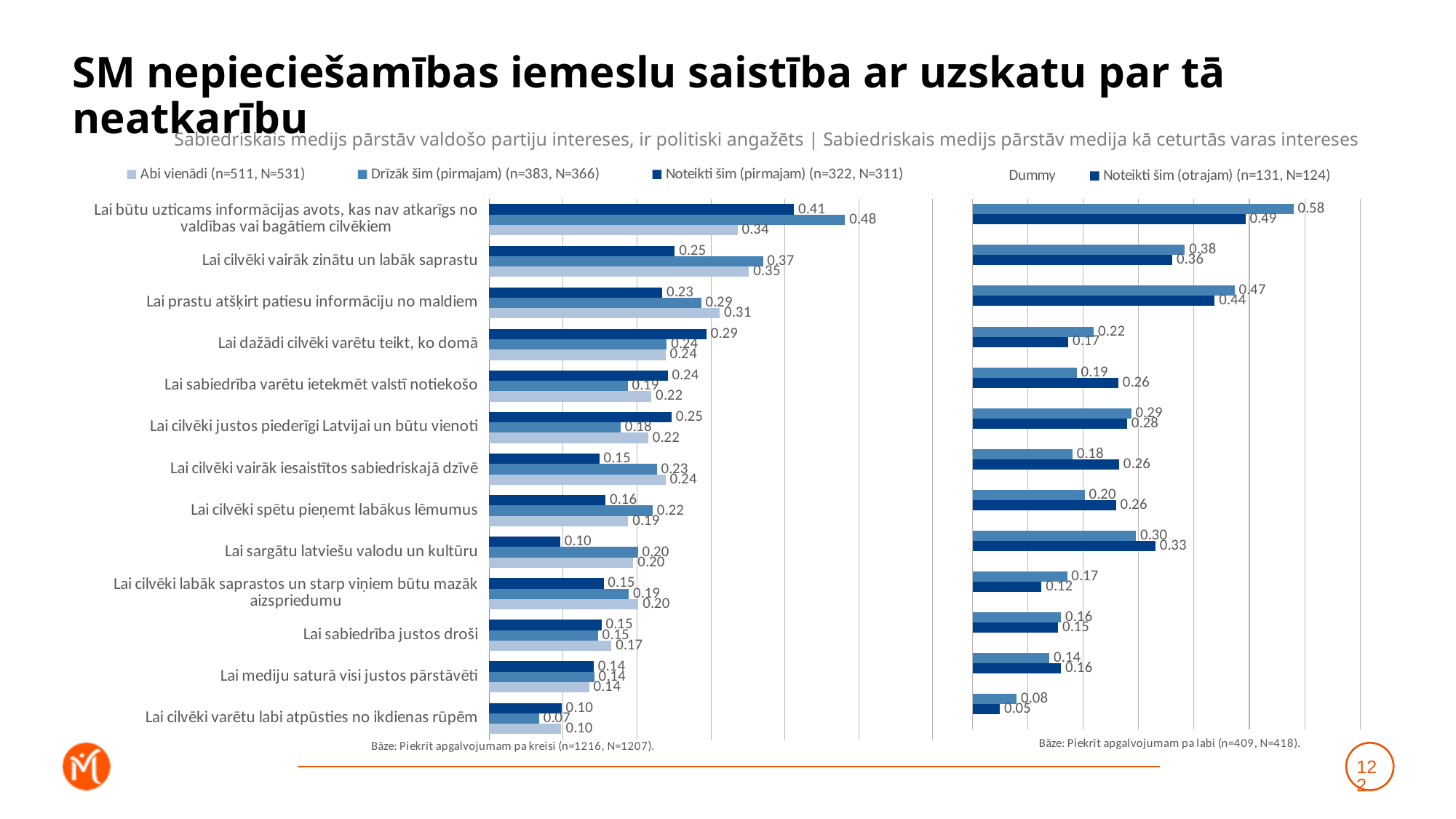
What type of chart is used on this slide? Bar chart On the left chart, what is the value of the 'Noteikti šim (pirmajam)' series for 'Lai būtu uzticams informācijas avots, kas nav atkarīgs no valdības vai bagātiem cilvēkiem'? 0.41 How many series does the legend of the left chart list? 3 On the left chart, for 'Lai dažādi cilvēki varētu teikt, ko domā', which is larger: the 'Noteikti šim (pirmajam)' value or the 'Abi vienādi' value? Noteikti šim (pirmajam) On the right chart, what is the difference between the two values shown for 'Lai būtu uzticams informācijas avots, kas nav atkarīgs no valdības vai bagātiem cilvēkiem'? 0.09 On the right chart, which category has the lowest value in the 'Noteikti šim (otrajam)' series? Lai cilvēki varētu labi atpūsties no ikdienas rūpēm On the left chart, which category has the highest value in the 'Drīzāk šim (pirmajam)' series? Lai būtu uzticams informācijas avots, kas nav atkarīgs no valdības vai bagātiem cilvēkiem On the left chart, what is the difference between the 'Drīzāk šim (pirmajam)' and 'Noteikti šim (pirmajam)' values for 'Lai cilvēki vairāk zinātu un labāk saprastu'? 0.12 On the right chart, what is the value of the 'Noteikti šim (otrajam)' series for 'Lai prastu atšķirt patiesu informāciju no maldiem'? 0.44 How many categories are listed on the left chart? 13 On the left chart, what is the value of the 'Abi vienādi' series for 'Lai prastu atšķirt patiesu informāciju no maldiem'? 0.31 On the right chart, what is the value of the 'Noteikti šim (otrajam)' series for 'Lai sargātu latviešu valodu un kultūru'? 0.33